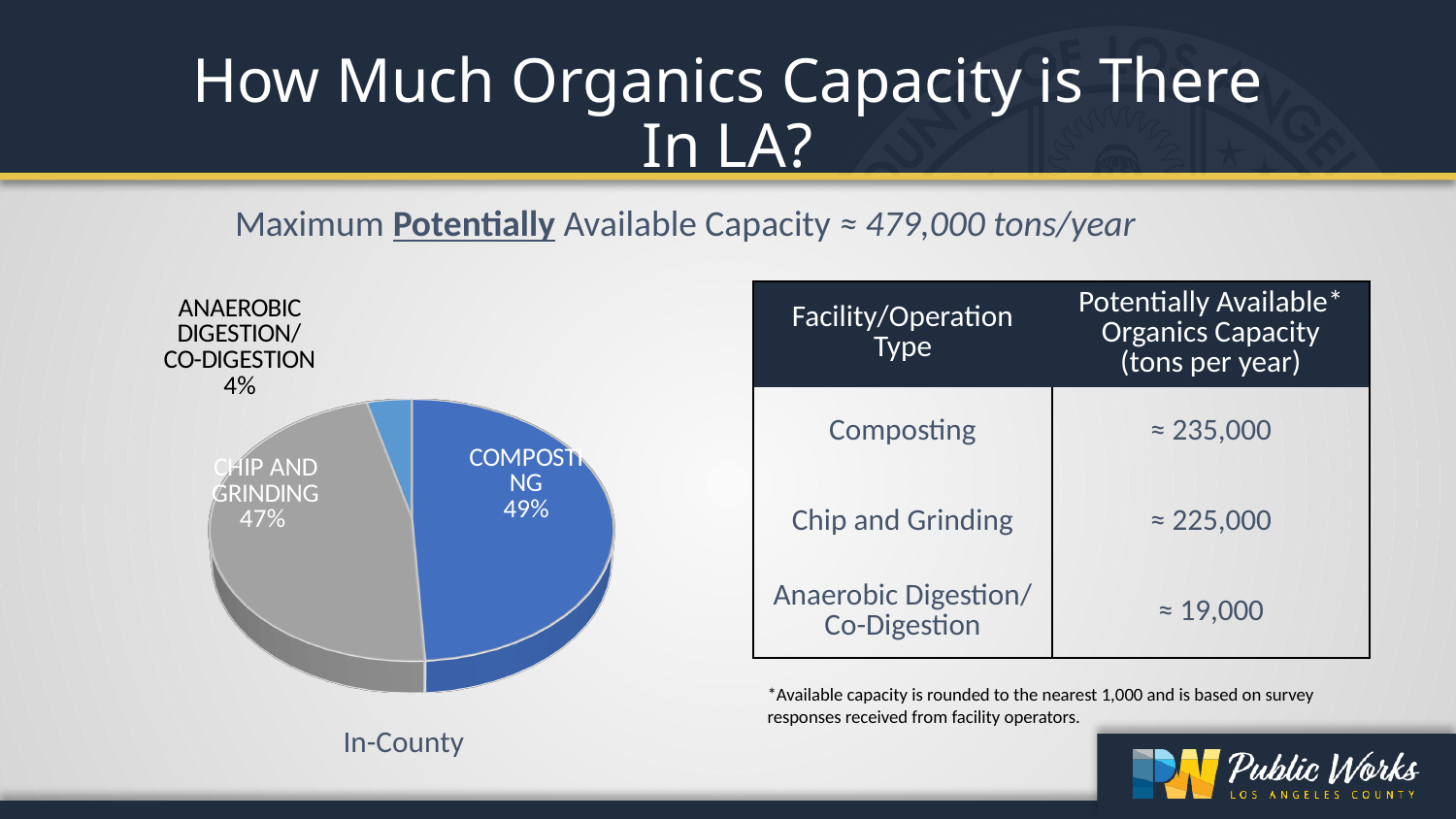
How many slices does the pie chart have? 3 Which category has the largest slice of the pie chart? Composting What share of the pie does Anaerobic Digestion/Co-Digestion represent? 4% Which category has the smallest slice of the pie chart? Anaerobic Digestion/Co-Digestion What share of the pie does Composting represent? 49% What is the difference in percentage points between the Composting and Chip and Grinding slices? 2 percentage points What share of the pie does Chip and Grinding represent? 47% Which is larger in the pie chart, Composting or Anaerobic Digestion/Co-Digestion? Composting What type of chart is shown on the slide? Pie chart What is the title shown below the pie chart? In-County What colour is the Chip and Grinding slice in the pie chart? Grey What is the difference in percentage points between the Chip and Grinding and Anaerobic Digestion/Co-Digestion slices? 43 percentage points